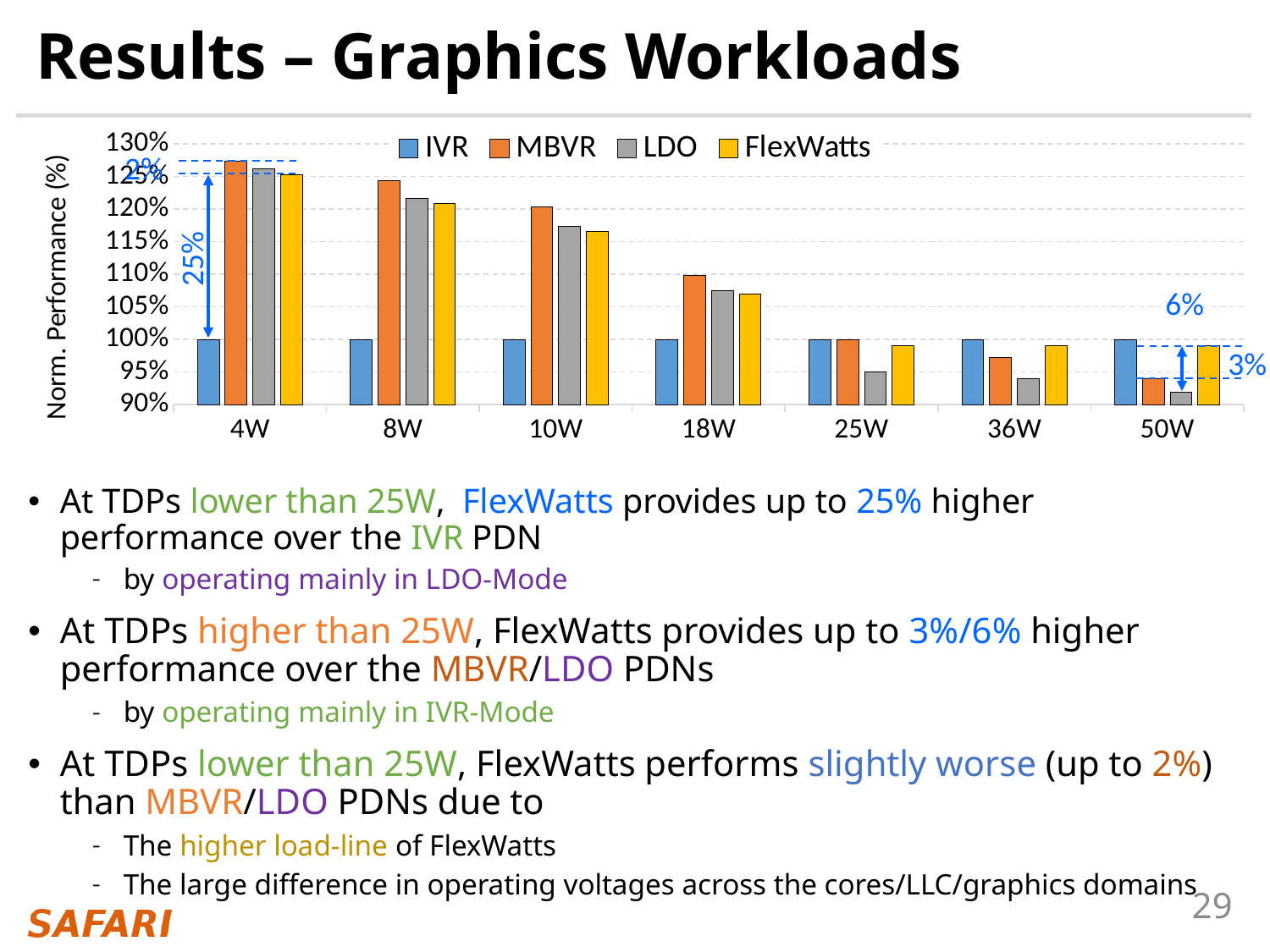
At 10W, which is larger: MBVR or FlexWatts? MBVR How many TDP categories are shown on the x axis? 7 What is the label of the y axis? Norm. Performance (%) Which series has the lowest value at 36W? LDO Is the value for LDO at 50W greater or less than 95%? less What is the normalized performance of IVR at 50W? 100% What is the normalized performance of IVR at 4W? 100% Is the value for MBVR at 4W greater or less than 120%? greater How many series does the legend list? 4 What kind of chart is shown on the slide? bar chart Do the MBVR values rise or fall as TDP increases from 4W to 50W? fall Is the value for FlexWatts at 18W greater or less than 105%? greater